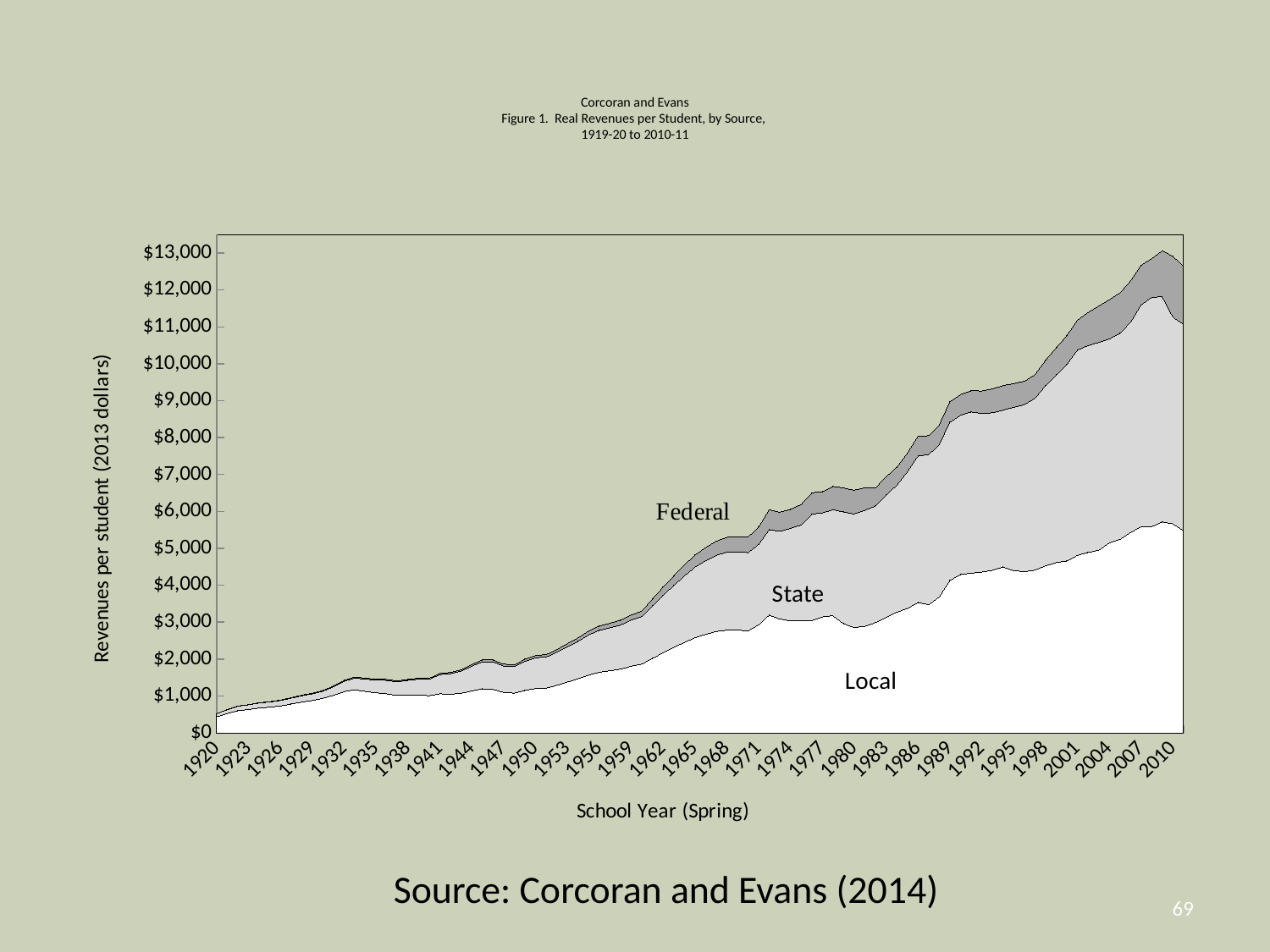
Is the Local revenue per student in 2001 greater or less than $4,000? greater Is the total revenue per student in 1920 greater or less than $1,000? less Is the total revenue per student in 1989 greater or less than $8,000? greater Do total real revenues per student generally rise or fall from 1920 to 2010? Rise Which revenue source forms the bottom area of the chart? Local What is the label of the y axis? Revenues per student (2013 dollars) What kind of chart is shown on the slide? Stacked area chart How many revenue sources are plotted as areas in the chart? 3